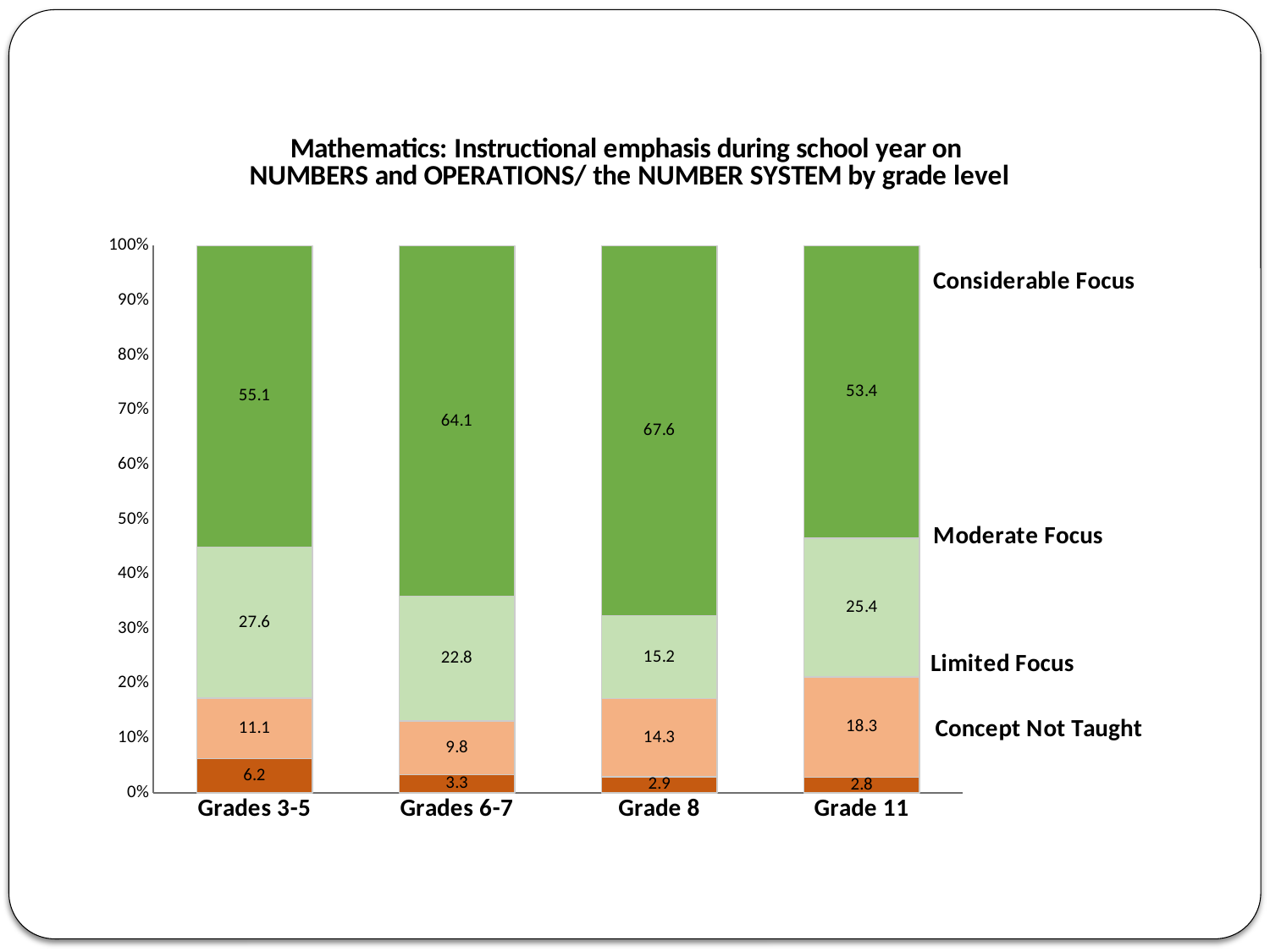
How many grade-level categories are shown on the x axis? 4 What is the Moderate Focus value for Grades 3-5? 27.6 What is the Limited Focus value for Grades 6-7? 9.8 What is the Considerable Focus value for Grade 8? 67.6 What is the difference between the Considerable Focus values for Grade 8 and Grade 11? 14.2 Which is larger: the Limited Focus value for Grade 11 or for Grade 8? Grade 11 Which series is shown in the darkest green colour at the top of each bar? Considerable Focus What kind of chart is shown on the slide? Stacked bar chart What is the Concept Not Taught value for Grade 11? 2.8 Which grade level has the highest Considerable Focus value? Grade 8 Which grade level has the lowest Concept Not Taught value? Grade 11 How many series (focus levels) does the chart show? 4